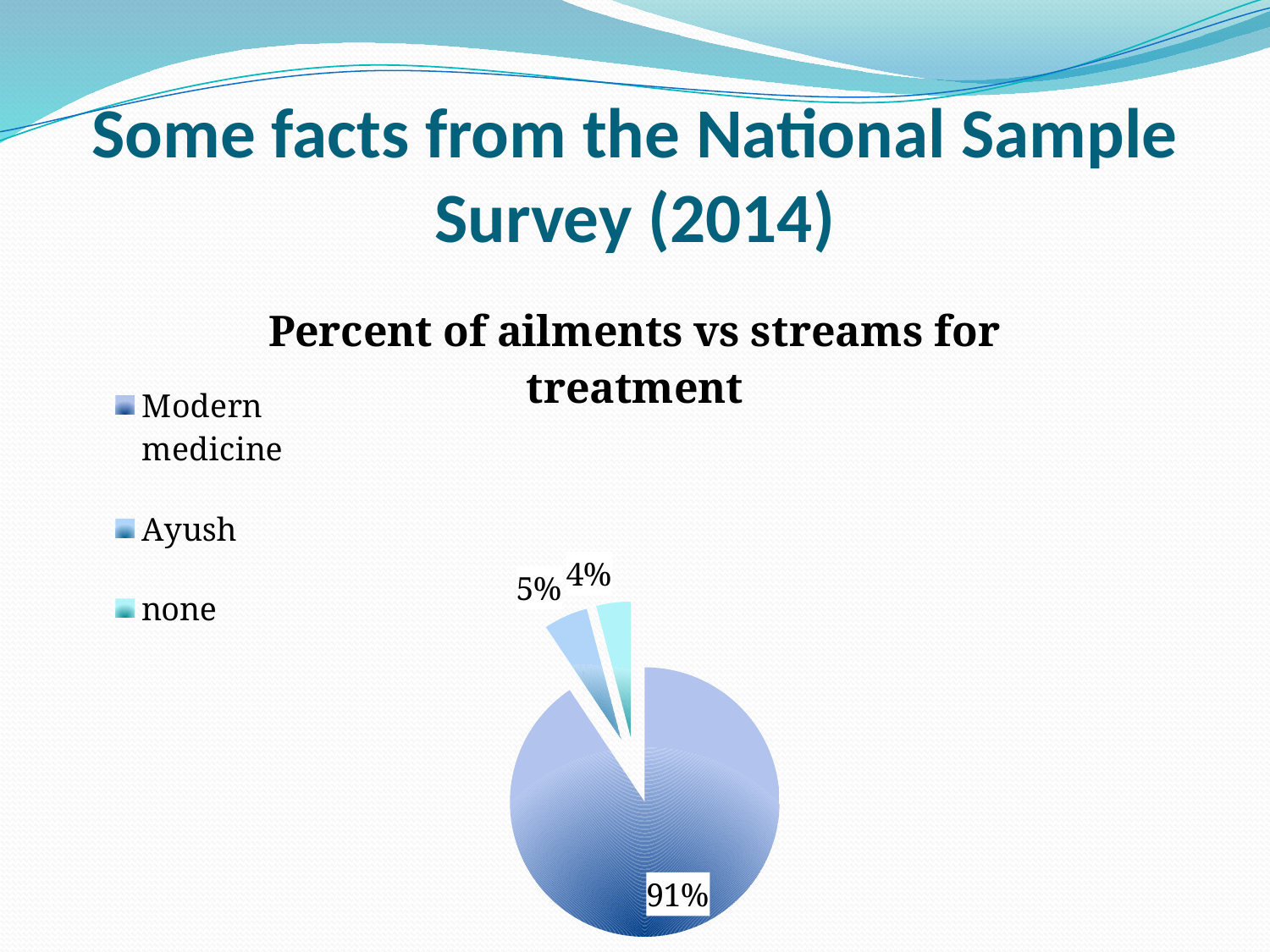
What percentage of ailments is treated with Modern medicine? 91% What percentage of ailments is shown for the 'none' category? 4% Which category has the smallest share of the pie? none Which category has the largest share of the pie? Modern medicine Which is larger, the share for Ayush or the share for none? Ayush What kind of chart is shown on the slide? pie chart What is the difference in percentage points between Modern medicine and Ayush? 86 What is the combined share of Ayush and none? 9% What is the title of the chart? Percent of ailments vs streams for treatment How many slices does the pie chart have? 3 What percentage of ailments is treated with Ayush? 5% How many entries does the chart legend list? 3